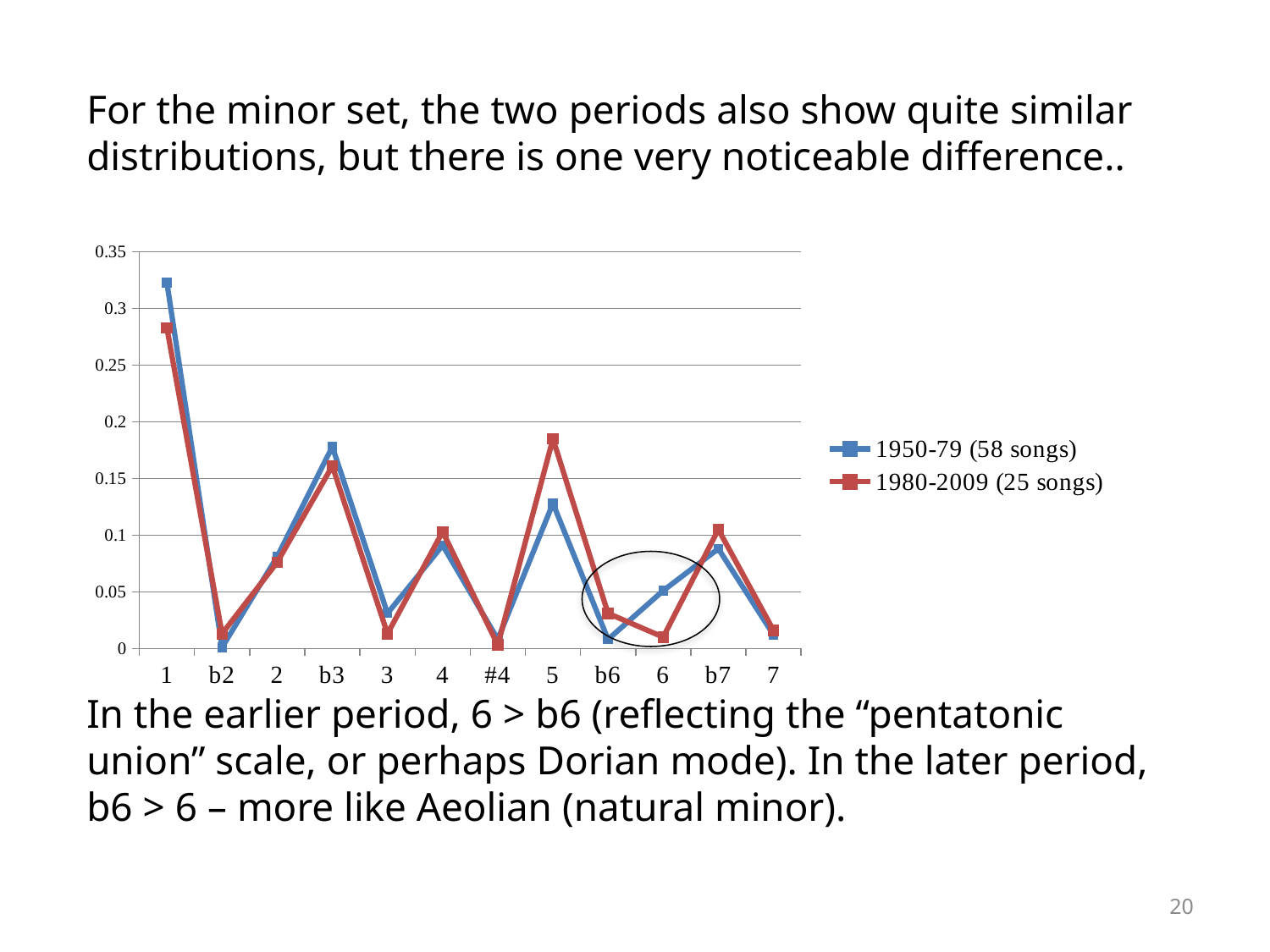
Which category has the highest value for the 1950-79 (58 songs) series? 1 For the 1980-2009 (25 songs) series, which is larger, the value at b6 or the value at 6? b6 Is the value for category 5 in the 1980-2009 (25 songs) series greater or less than 0.15? greater Is the value for category 5 in the 1950-79 (58 songs) series greater or less than 0.15? less Is the value for category 1 in the 1950-79 (58 songs) series greater or less than 0.3? greater For the 1950-79 (58 songs) series, which is larger, the value at b6 or the value at 6? 6 Which category has the highest value for the 1980-2009 (25 songs) series? 1 What kind of chart is shown on the slide? line chart At category 1, which series has the larger value, 1950-79 (58 songs) or 1980-2009 (25 songs)? 1950-79 (58 songs) How many series does the legend list? 2 How many categories are shown along the x axis? 12